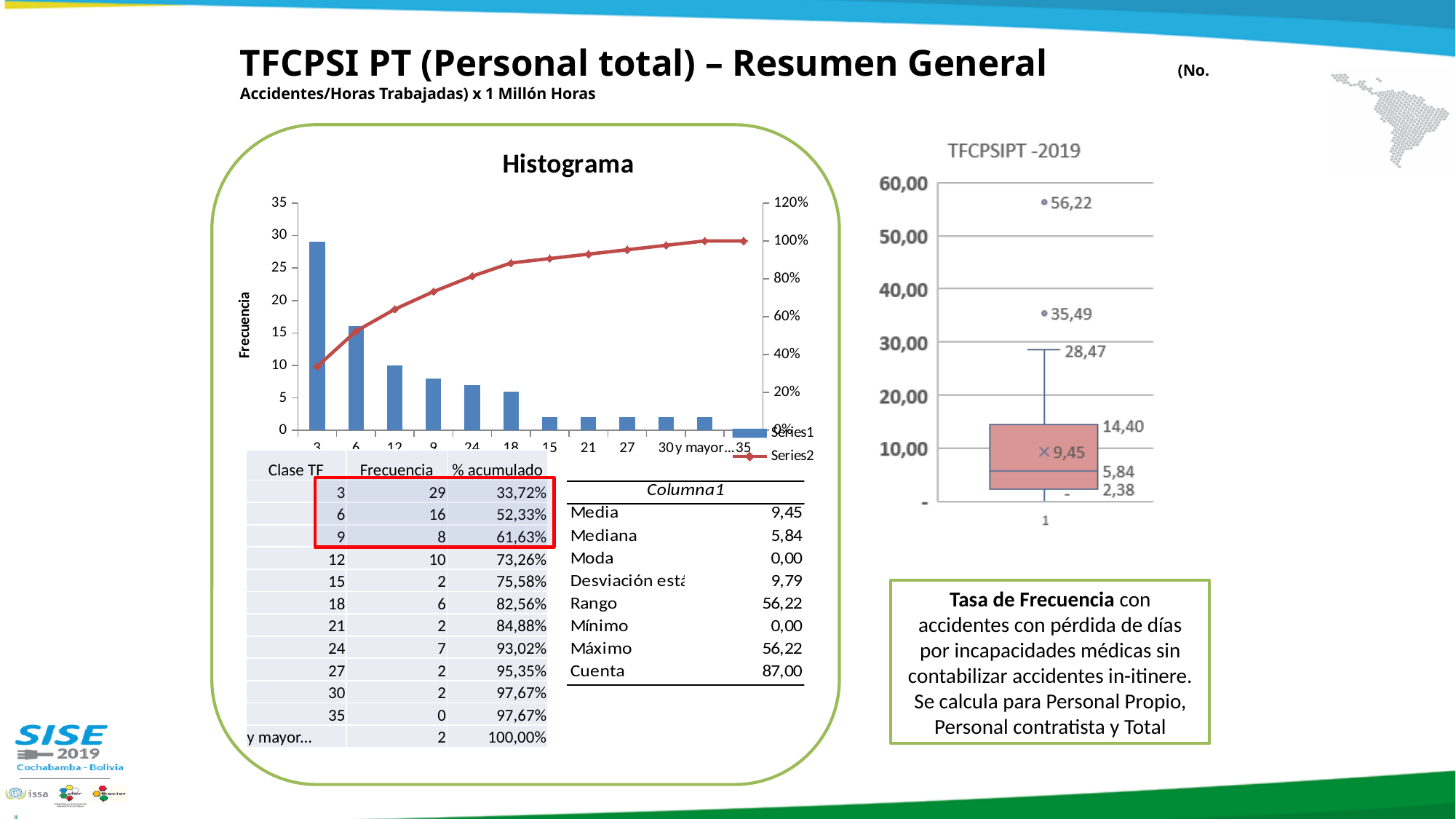
In the TFCPSIPT -2019 box plot, what is the lowest labelled value? 2,38 In the Histograma chart, is the bar for class 3 greater or less than 25? greater In the Histograma chart, which Clase TF category has the tallest bar? 3 In the TFCPSIPT -2019 box plot, what is the highest labelled value? 56,22 In the Histograma chart, what is the frequency for class 3 according to the table on the slide? 29 In the TFCPSIPT -2019 box plot, what value is shown at the x (mean) marker? 9,45 What is the title of the chart on the right side of the slide? TFCPSIPT -2019 In the Histograma chart, is the bar for class 6 greater or less than 20? less In the Histograma chart, how many series does the legend list? 2 In the Histograma chart, does the Series2 line rise or fall from left to right? rises In the Histograma chart, what kind of chart is used to show the Frecuencia values? bar chart (with a cumulative line) In the TFCPSIPT -2019 box plot, what is the difference between the two outlier values 56,22 and 35,49? 20,73